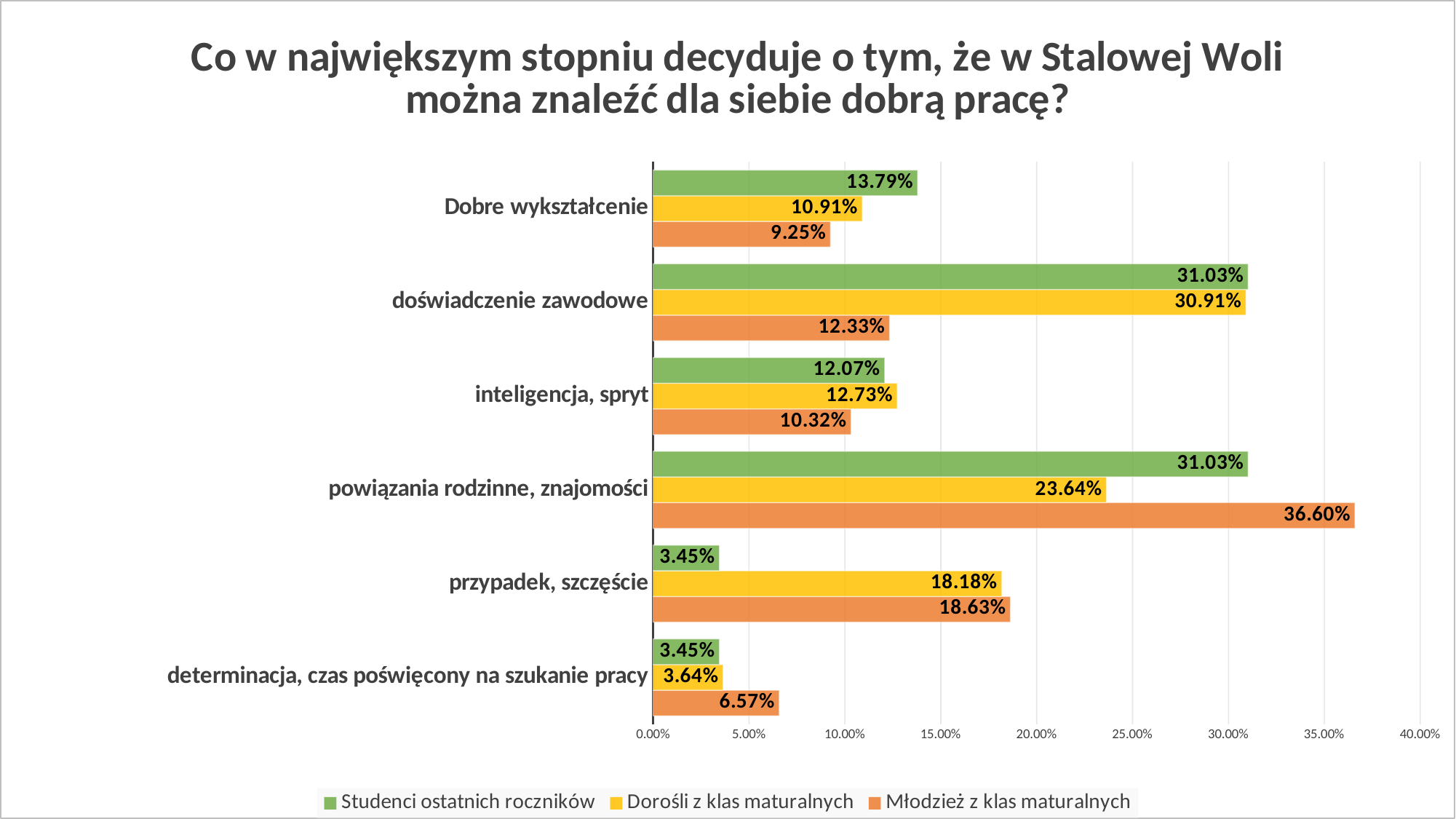
Which category has the highest value for Dorośli z klas maturalnych? doświadczenie zawodowe For 'przypadek, szczęście', which series has the larger value: Studenci ostatnich roczników or Dorośli z klas maturalnych? Dorośli z klas maturalnych Which category has the highest value for Młodzież z klas maturalnych? powiązania rodzinne, znajomości How many categories are shown on the chart? 6 What is the difference between the Studenci ostatnich roczników and Młodzież z klas maturalnych values for 'doświadczenie zawodowe'? 18.70 percentage points What is the value for Studenci ostatnich roczników for 'przypadek, szczęście'? 3.45% What is the value for Dorośli z klas maturalnych for 'Dobre wykształcenie'? 10.91% What is the value for Młodzież z klas maturalnych for 'powiązania rodzinne, znajomości'? 36.60% What kind of chart is shown on the slide? Bar chart Which category has the lowest value for Młodzież z klas maturalnych? determinacja, czas poświęcony na szukanie pracy How many series does the legend list? 3 What is the difference between the Młodzież z klas maturalnych and Dorośli z klas maturalnych values for 'powiązania rodzinne, znajomości'? 12.96 percentage points